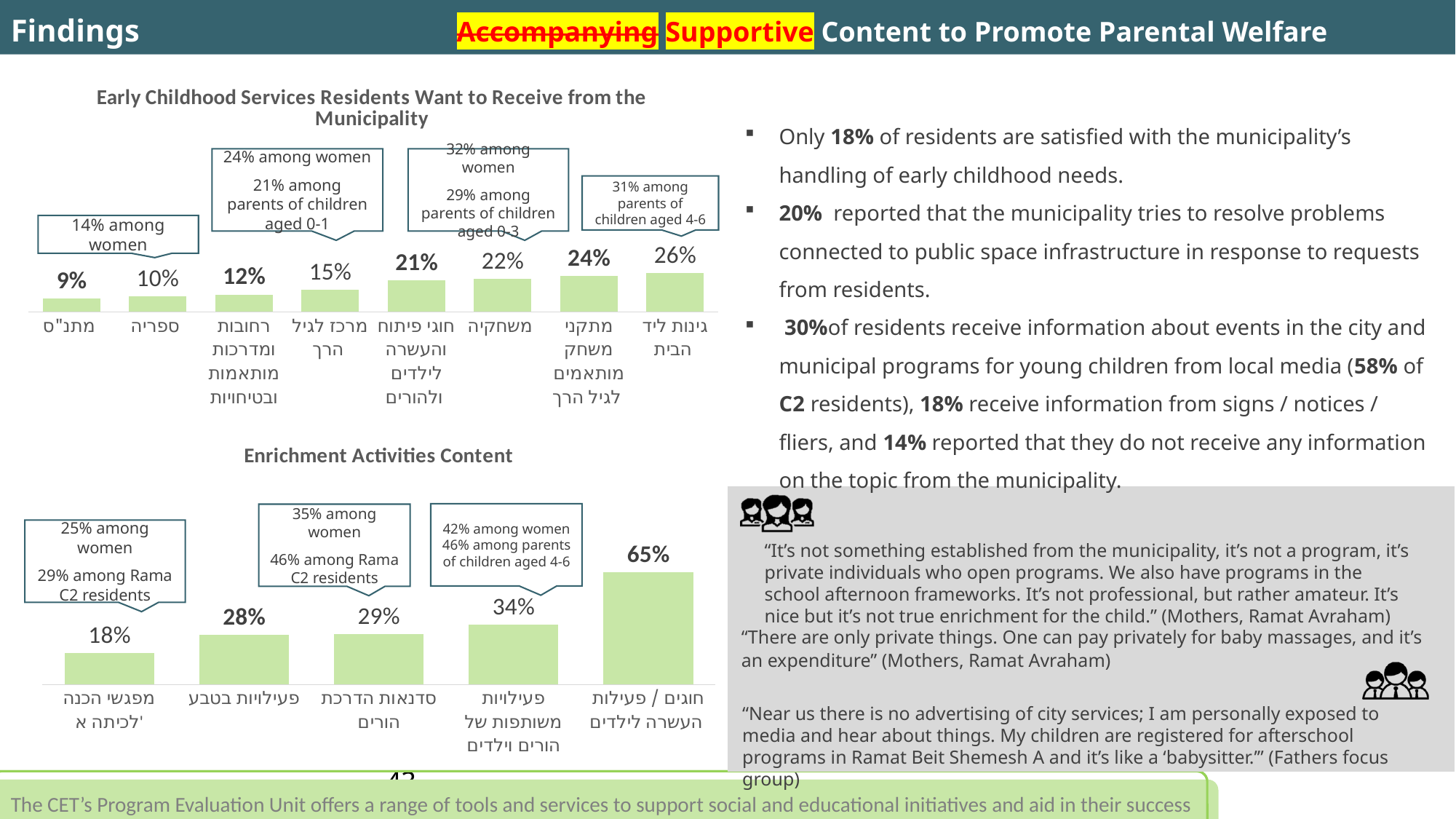
In the 'Enrichment Activities Content' chart, what is the value for פעילויות בטבע? 28% In the 'Enrichment Activities Content' chart, what is the value for חוגים / פעילות העשרה לילדים? 65% In the 'Early Childhood Services Residents Want to Receive from the Municipality' chart, which category has the lowest value? מתנ"ס In the 'Early Childhood Services Residents Want to Receive from the Municipality' chart, what is the difference between the values for מרכז לגיל הרך and ספריה? 5% In the 'Early Childhood Services Residents Want to Receive from the Municipality' chart, how many categories are shown? 8 What type of chart is the 'Enrichment Activities Content' chart? bar chart In the 'Early Childhood Services Residents Want to Receive from the Municipality' chart, what is the value for משחקיה? 22% In the 'Early Childhood Services Residents Want to Receive from the Municipality' chart, what is the value for גינות ליד הבית? 26% In the 'Enrichment Activities Content' chart, what is the difference between the values for חוגים / פעילות העשרה לילדים and פעילויות משותפות של הורים וילדים? 31% In the 'Early Childhood Services Residents Want to Receive from the Municipality' chart, which category has the highest value? גינות ליד הבית In the 'Early Childhood Services Residents Want to Receive from the Municipality' chart, do the values rise or fall from left to right? rise In the 'Enrichment Activities Content' chart, which category has the lowest value? מפגשי הכנה לכיתה א'